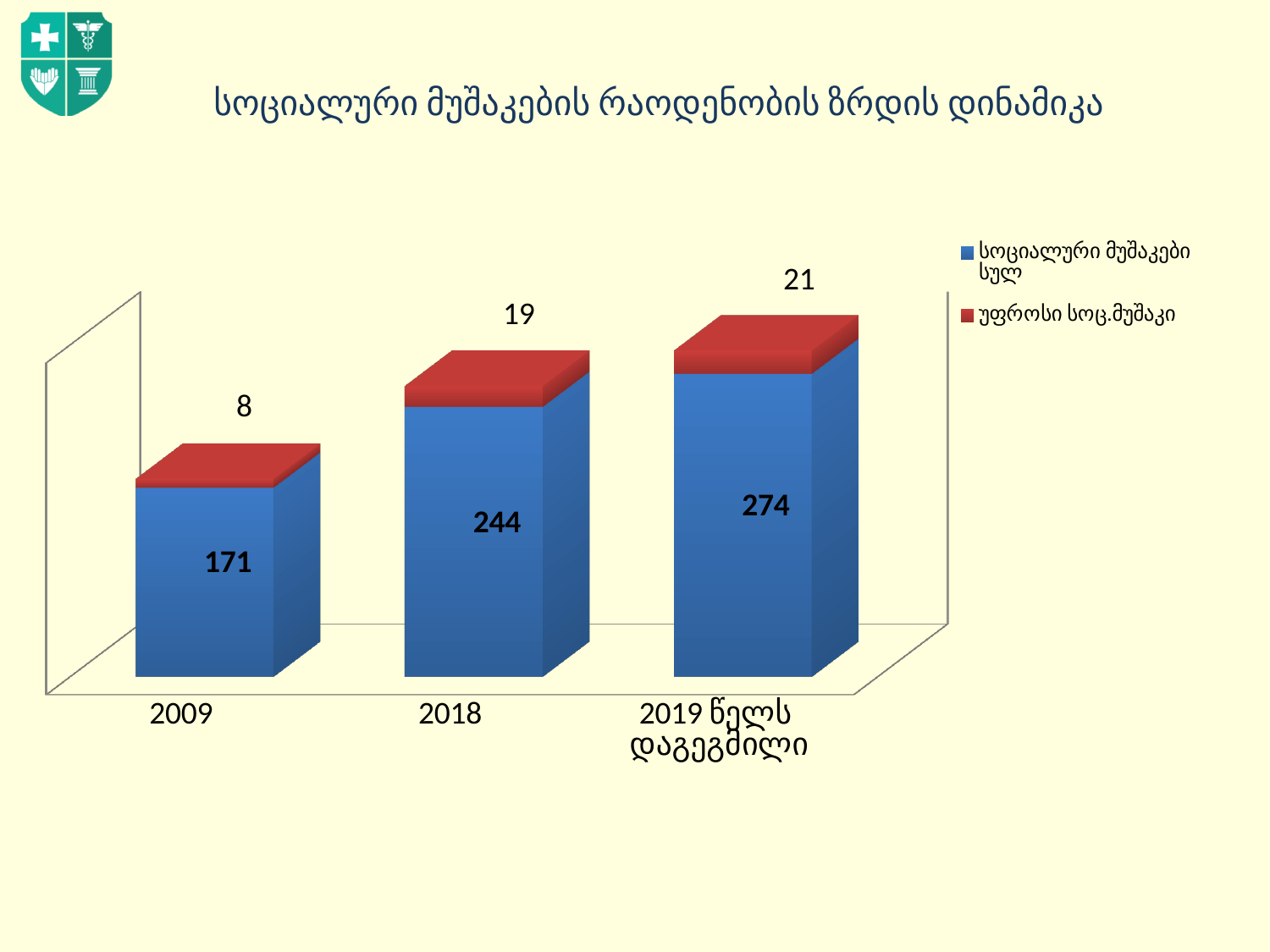
What is the total of the stacked bar for 2018? 263 What is the value of the blue series (სოციალური მუშაკები სულ) for 2009? 171 What is the value of the red series (უფროსი სოც.მუშაკი) for 2019 წელს დაგეგმილი? 21 What is the value of the red series (უფროსი სოც.მუშაკი) for 2009? 8 What type of chart is shown on the slide? stacked bar chart Do the values of the blue series rise or fall from 2009 to 2019 წელს დაგეგმილი? rise Which category has the lowest value for the red series (უფროსი სოც.მუშაკი)? 2009 What is the value of the blue series (სოციალური მუშაკები სულ) for 2018? 244 Which category has the highest value for the blue series (სოციალური მუშაკები სულ)? 2019 წელს დაგეგმილი How many series does the legend list? 2 How many categories are shown on the x axis? 3 What is the difference between the blue series values for 2018 and 2009? 73